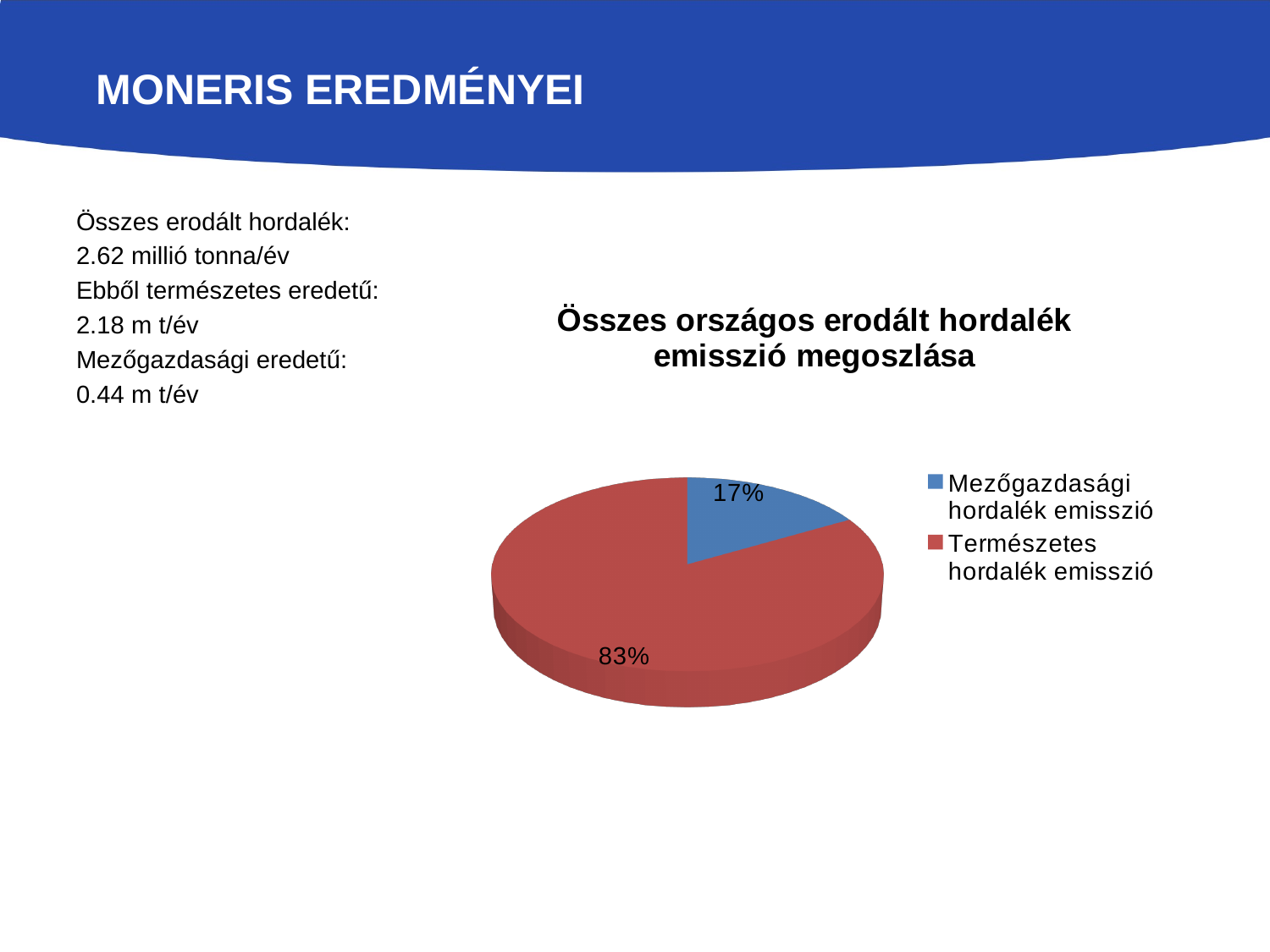
How many entries does the legend list? 2 Which is larger, the Mezőgazdasági hordalék emisszió slice or the Természetes hordalék emisszió slice? Természetes hordalék emisszió What kind of chart is shown on the slide? pie chart How many slices does the pie chart have? 2 Which slice of the pie is the smallest? Mezőgazdasági hordalék emisszió What share of the pie is Természetes hordalék emisszió? 83% What share of the pie is Mezőgazdasági hordalék emisszió? 17% What is the title of the chart? Összes országos erodált hordalék emisszió megoszlása What colour is the Természetes hordalék emisszió slice? red Which slice of the pie is the largest? Természetes hordalék emisszió What is the difference in percentage points between the Természetes hordalék emisszió slice and the Mezőgazdasági hordalék emisszió slice? 66 percentage points